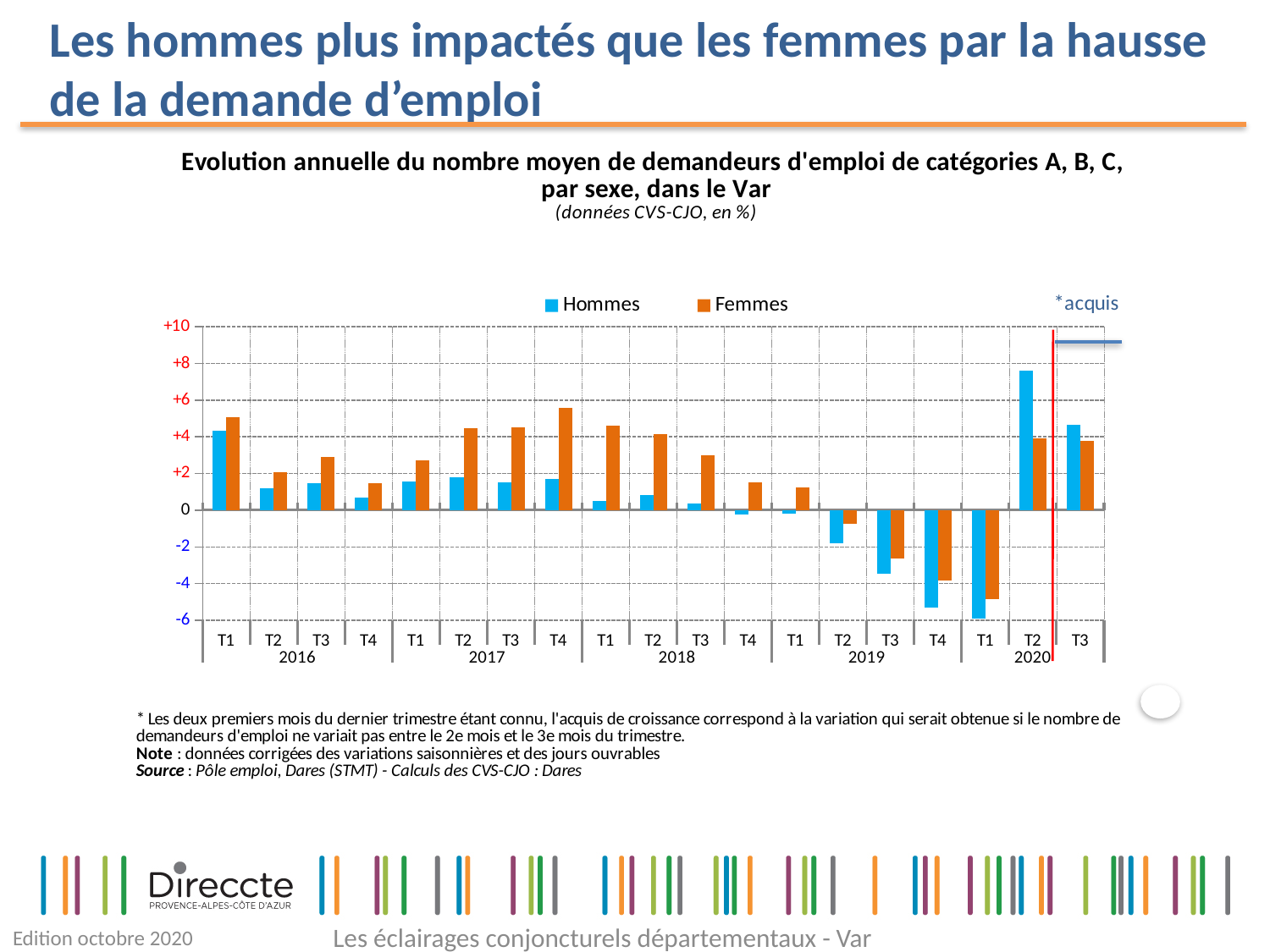
In which quarter is the Hommes value highest? T2 2020 In which quarter is the Hommes value lowest? T1 2020 Is the Hommes value for T1 2020 greater or less than -4? less In T2 2017, which series has the larger value, Hommes or Femmes? Femmes Which colour represents the Hommes series in the legend? blue Is the Hommes value for T2 2020 greater or less than +6? greater In which quarter is the Femmes value lowest? T1 2020 In T2 2020, which series has the larger value, Hommes or Femmes? Hommes Is the Femmes value for T4 2017 greater or less than +4? greater How many quarters (bar groups) are plotted along the x axis? 19 How many series does the legend list? 2 What kind of chart is shown on the slide? bar chart